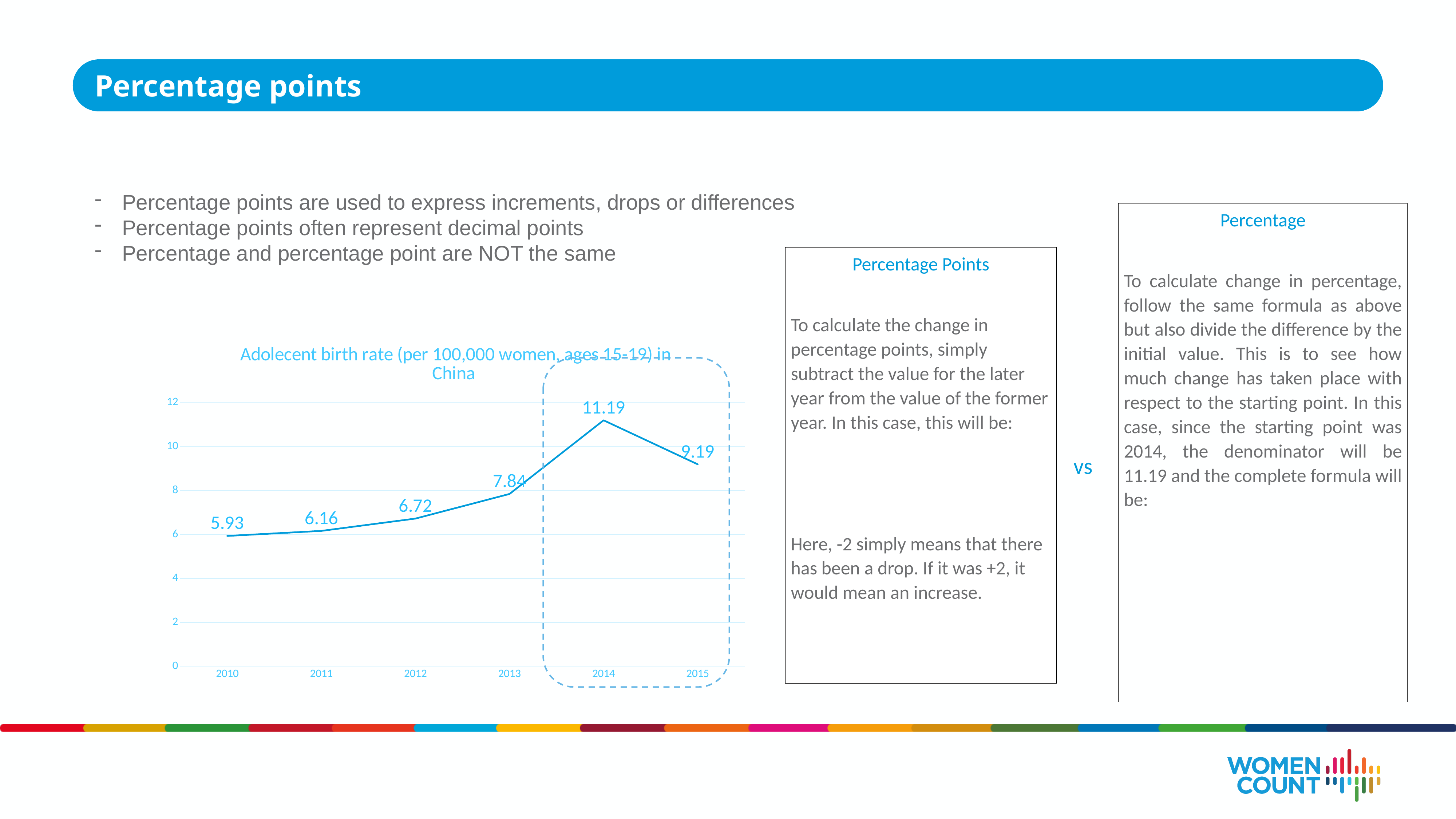
What is the adolescent birth rate value shown for 2010? 5.93 What is the difference between the 2013 value and the 2012 value? 1.12 What is the title of the chart? Adolecent birth rate (per 100,000 women, ages 15-19) in China How many years are plotted on the chart? 6 What is the adolescent birth rate value shown for 2014? 11.19 Is the value for 2014 greater or less than 10? greater Which year has the highest adolescent birth rate on the chart? 2014 What is the difference between the 2014 value and the 2015 value? 2 What kind of chart is shown on the slide? line chart Which is larger, the value for 2011 or the value for 2013? 2013 What is the value plotted for 2015? 9.19 Which year has the lowest adolescent birth rate on the chart? 2010